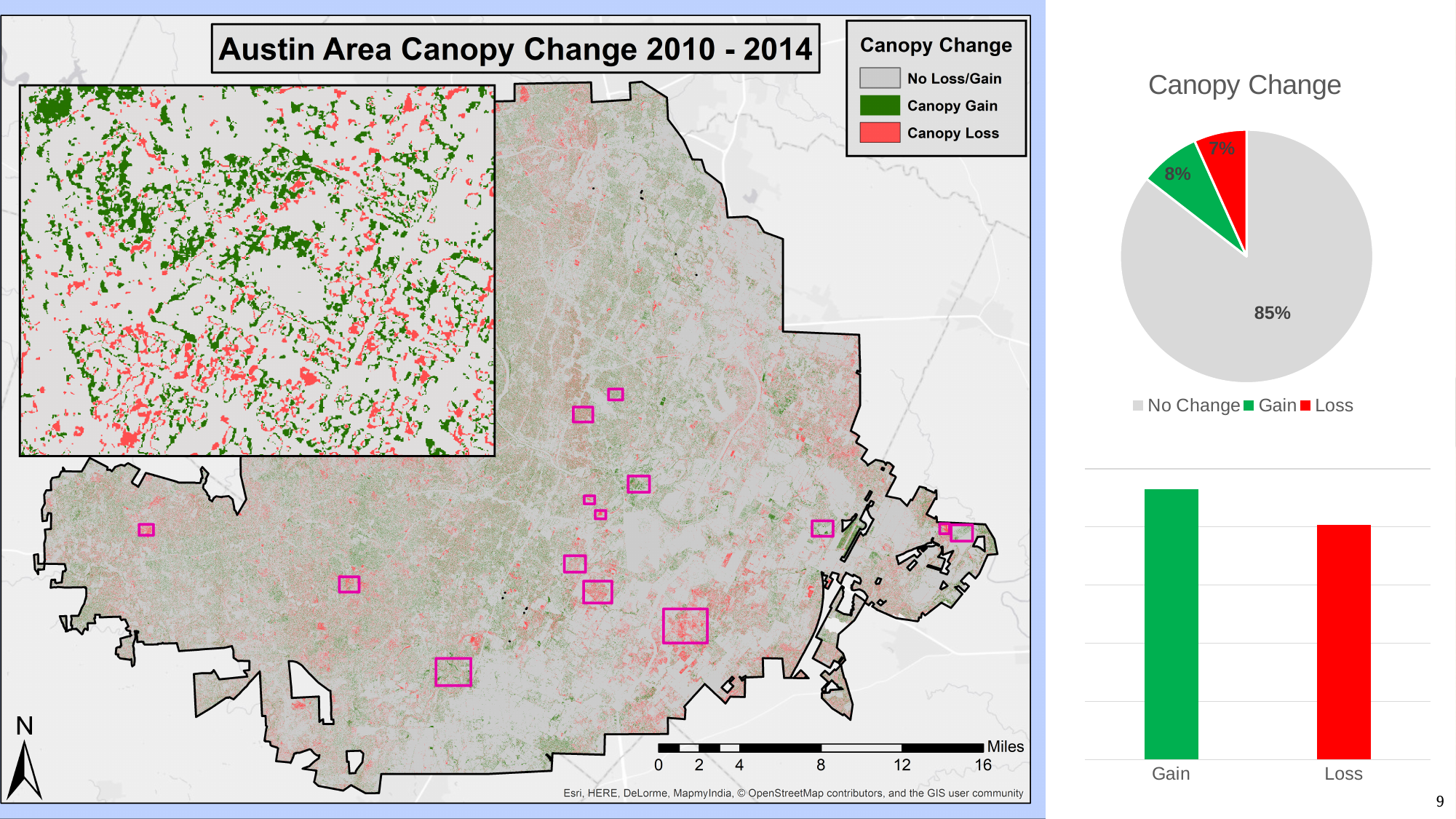
In the pie chart titled "Canopy Change", what is the difference between the No Change share and the Gain share? 77% In the bar chart at the bottom right of the slide, what colour is the Loss bar? Red In the pie chart titled "Canopy Change", which category has the largest slice? No Change In the bar chart at the bottom right of the slide, how many bars are plotted? 2 In the pie chart titled "Canopy Change", what share is labelled for Gain? 8% In the pie chart titled "Canopy Change", what share is labelled for Loss? 7% In the pie chart titled "Canopy Change", how many categories does the legend list? 3 In the pie chart titled "Canopy Change", what share is labelled for No Change? 85% What kind of chart is shown at the bottom right of the slide, below the pie chart? Bar chart In the bar chart at the bottom right of the slide, which bar is taller, Gain or Loss? Gain In the pie chart titled "Canopy Change", what colour is the Gain slice? Green In the pie chart titled "Canopy Change", which category has the smallest slice? Loss